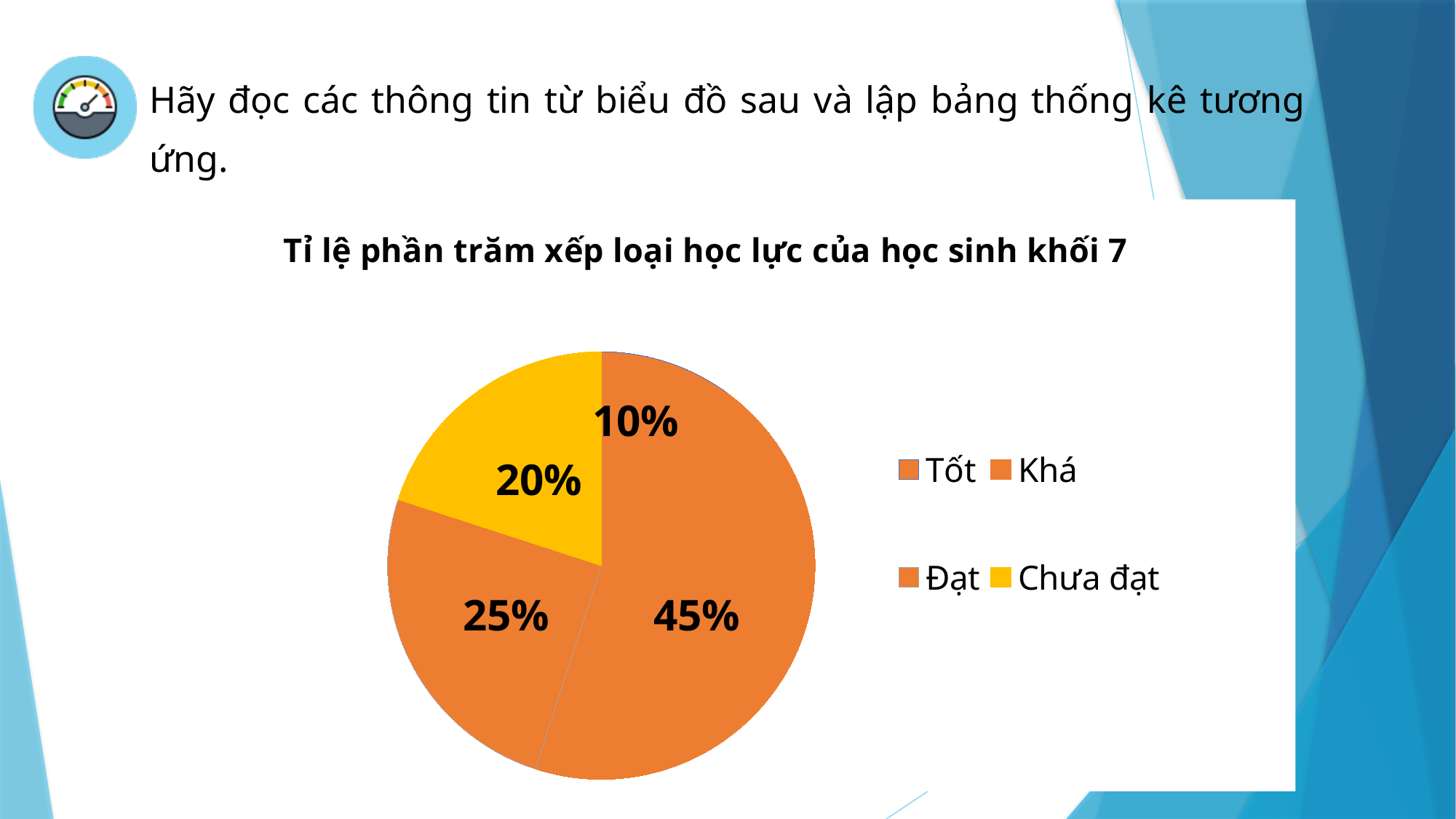
How many categories does the legend of the pie chart list? 4 What do the four slice labels on the pie chart add up to? 100% Is the share for Chưa đạt greater or less than 25%? less What is the title of the chart? Tỉ lệ phần trăm xếp loại học lực của học sinh khối 7 What is the largest percentage label shown on the pie chart? 45% What is the smallest percentage label shown on the pie chart? 10% How many slices does the pie chart have? 4 Which category is shown in yellow in the pie chart? Chưa đạt What type of chart is shown on the slide? pie chart What is the difference between the largest and smallest slice labels on the pie chart? 35% Which is larger: the Chưa đạt slice (20%) or the slice labelled 45%? the slice labelled 45% What percentage of the pie is labelled for Chưa đạt? 20%